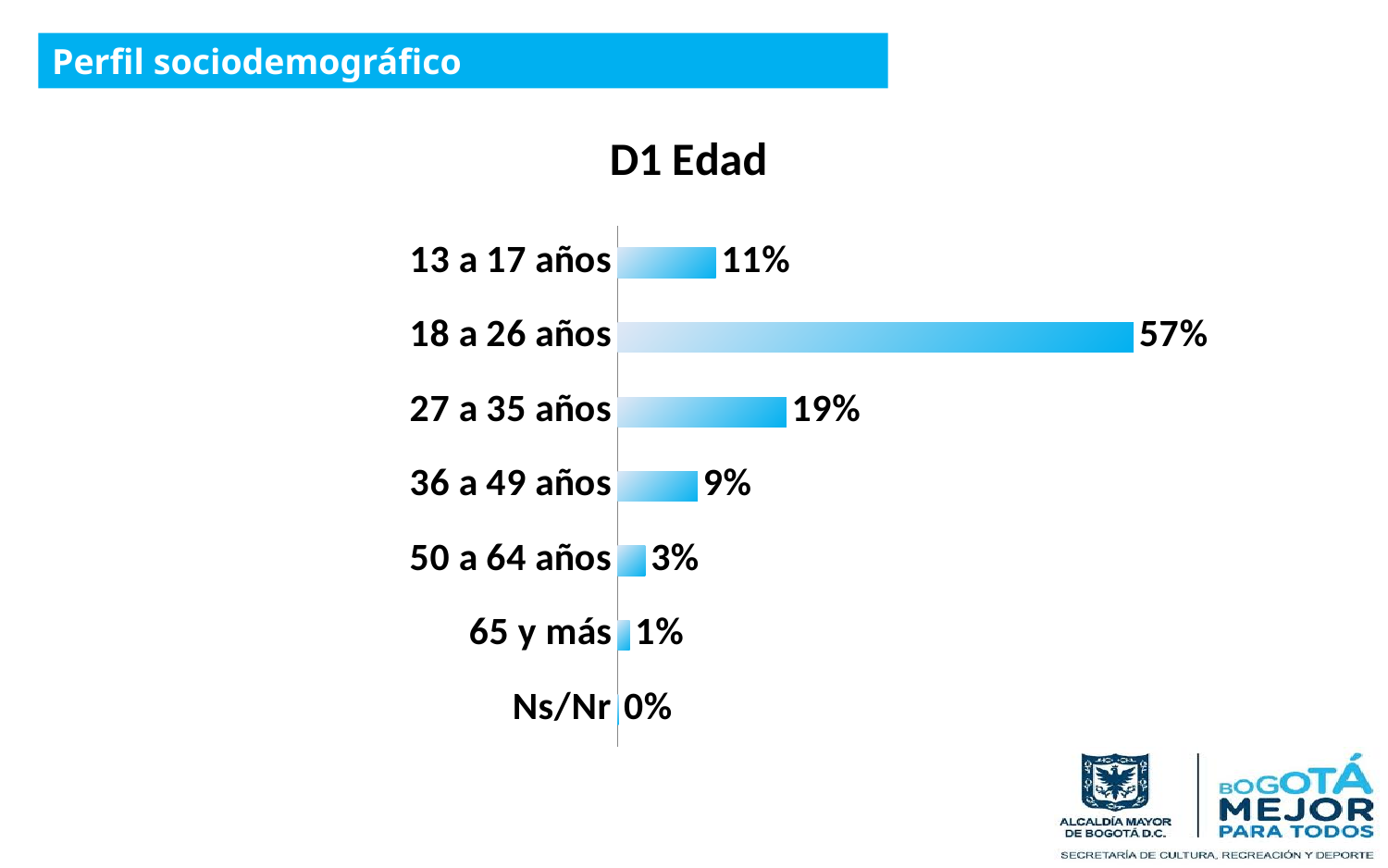
Which is larger, the value for 27 a 35 años or the value for 50 a 64 años? 27 a 35 años What is the difference between the values for 13 a 17 años and 36 a 49 años? 2% What is the value for the 18 a 26 años category? 57% What is the title of the chart? D1 Edad What is the value for the 13 a 17 años category? 11% What is the difference between the values for 18 a 26 años and 27 a 35 años? 38% What kind of chart is shown on the slide? Bar chart What is the value for the 36 a 49 años category? 9% Which category has the highest value? 18 a 26 años How many categories are shown in the chart? 7 What is the value for the 65 y más category? 1% Which category has the lowest value? Ns/Nr